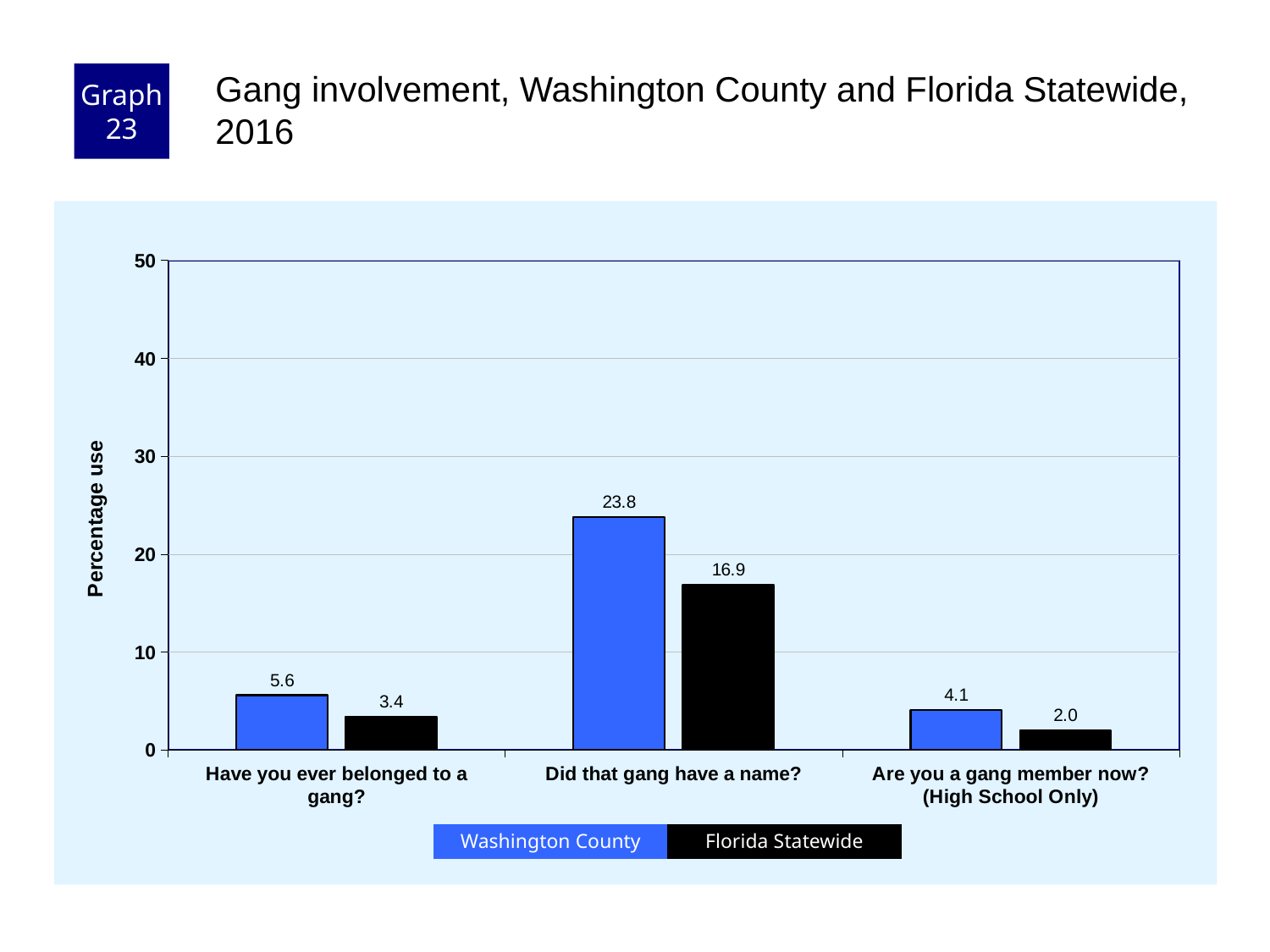
What is the Washington County value for "Did that gang have a name?"? 23.8 What is the Florida Statewide value for "Are you a gang member now? (High School Only)"? 2.0 For "Have you ever belonged to a gang?", which is larger: Washington County or Florida Statewide? Washington County Which question has the lowest Florida Statewide value? Are you a gang member now? (High School Only) What kind of chart is shown? Bar chart What is the difference between the Washington County and Florida Statewide values for "Did that gang have a name?"? 6.9 What is the Florida Statewide value for "Have you ever belonged to a gang?"? 3.4 What is the label on the y axis? Percentage use How many questions (categories) are shown on the x axis? 3 How many series does the legend list? 2 Is the Washington County value for "Did that gang have a name?" greater or less than 20? greater Which question has the highest Washington County value? Did that gang have a name?